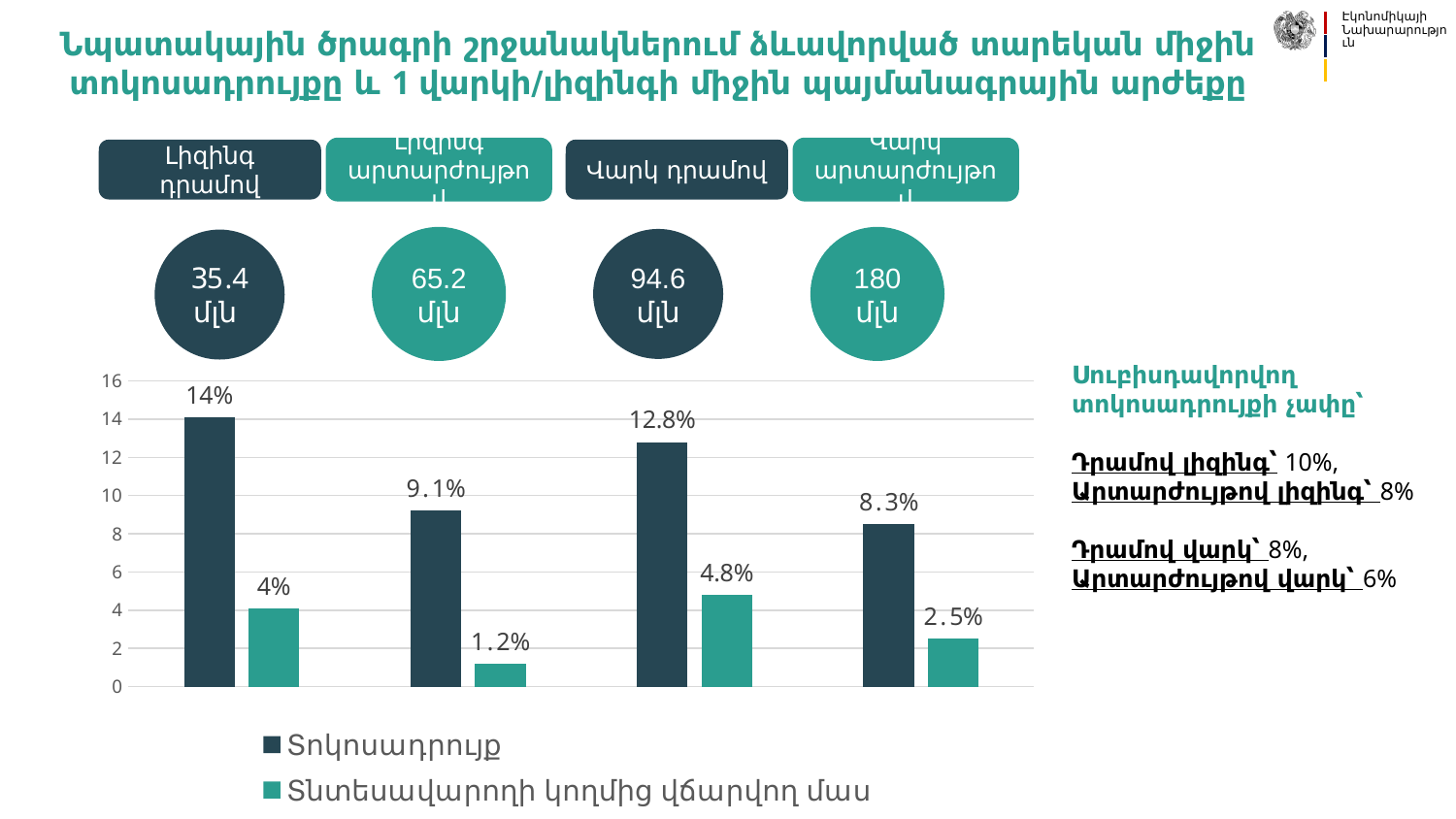
Which is larger: the Տնտեսավարողի կողմից վճարվող մաս value in the first group or in the fourth group? the first group What is the difference between the Տոկոսադրույք values of the first group (14%) and the third group (12.8%)? 1.2% Which group has the lowest Տնտեսավարողի կողմից վճարվող մաս value? the second group How many series does the chart legend list? 2 What type of chart is shown on the slide? bar chart What is the value of the Տոկոսադրույք bar in the fourth group? 8.3% Which group has the highest Տոկոսադրույք value? the first group (Լիզինգ դրամով) What is the value of the Տնտեսավարողի կողմից վճարվող մաս bar in the third group (Վարկ դրամով)? 4.8% How many groups of bars are plotted in the chart? 4 Which colour represents the Տոկոսադրույք series in the chart? dark blue-grey What is the value of the Տոկոսադրույք bar in the first group (Լիզինգ դրամով)? 14% Is the Տոկոսադրույք value in the second group greater or less than 10? less